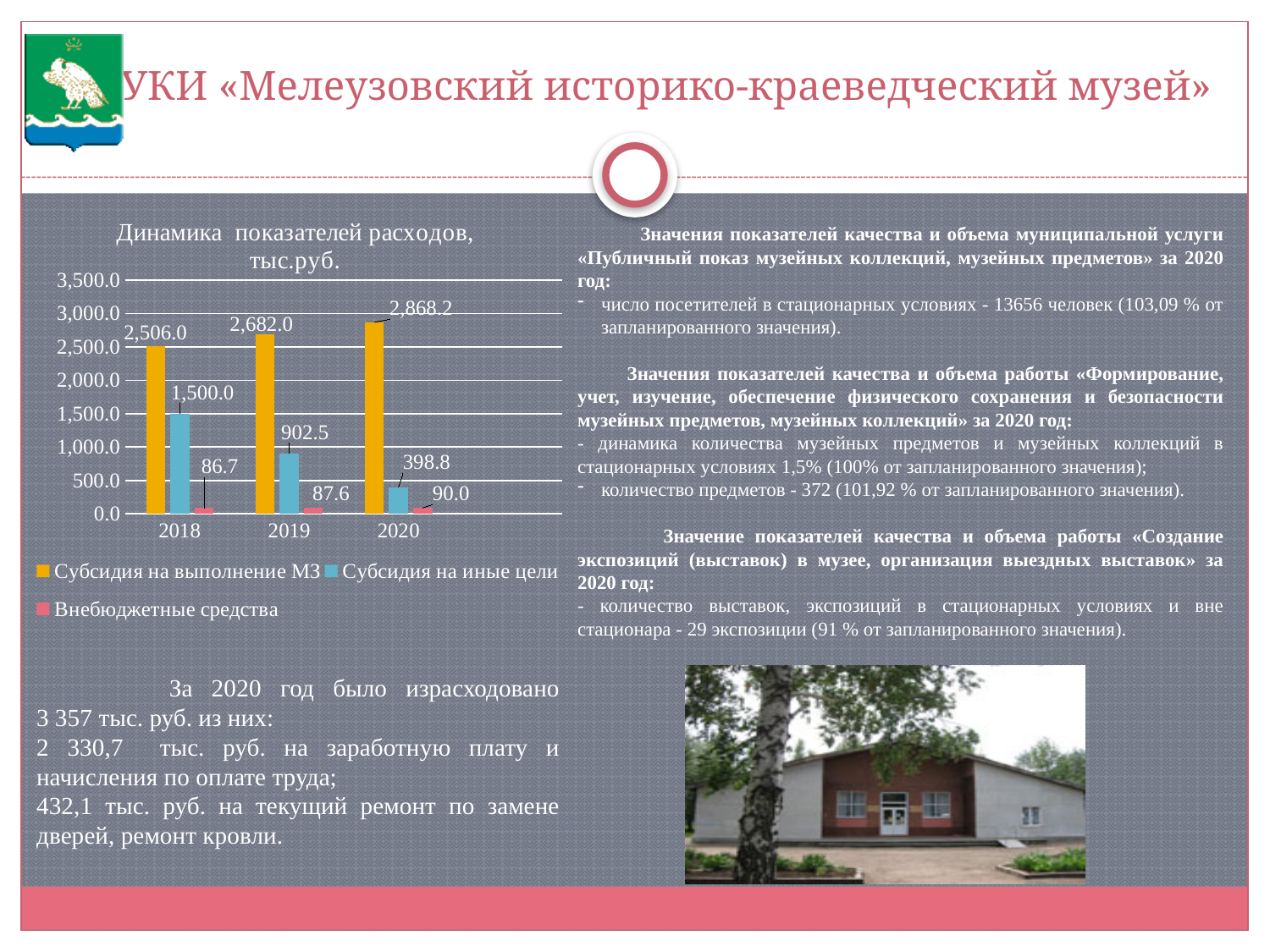
Which colour represents "Внебюджетные средства" in the chart "Динамика показателей расходов, тыс.руб."? pink What is the value of "Внебюджетные средства" for 2018 in the chart "Динамика показателей расходов, тыс.руб."? 86.7 Does "Субсидия на выполнение МЗ" rise or fall from 2018 to 2020 in the chart "Динамика показателей расходов, тыс.руб."? rise How many series does the legend of the chart "Динамика показателей расходов, тыс.руб." list? 3 In which year is "Субсидия на выполнение МЗ" lowest in the chart "Динамика показателей расходов, тыс.руб."? 2018 What is the difference between "Субсидия на выполнение МЗ" in 2020 and in 2018 in the chart "Динамика показателей расходов, тыс.руб."? 362.2 What type of chart is "Динамика показателей расходов, тыс.руб."? bar chart In which year is "Субсидия на иные цели" highest in the chart "Динамика показателей расходов, тыс.руб."? 2018 What is the value of "Субсидия на выполнение МЗ" for 2020 in the chart "Динамика показателей расходов, тыс.руб."? 2,868.2 Which is larger in the chart "Динамика показателей расходов, тыс.руб.": "Субсидия на иные цели" in 2019 or in 2020? 2019 How many years are shown on the x axis of the chart "Динамика показателей расходов, тыс.руб."? 3 What is the value of "Субсидия на иные цели" for 2019 in the chart "Динамика показателей расходов, тыс.руб."? 902.5